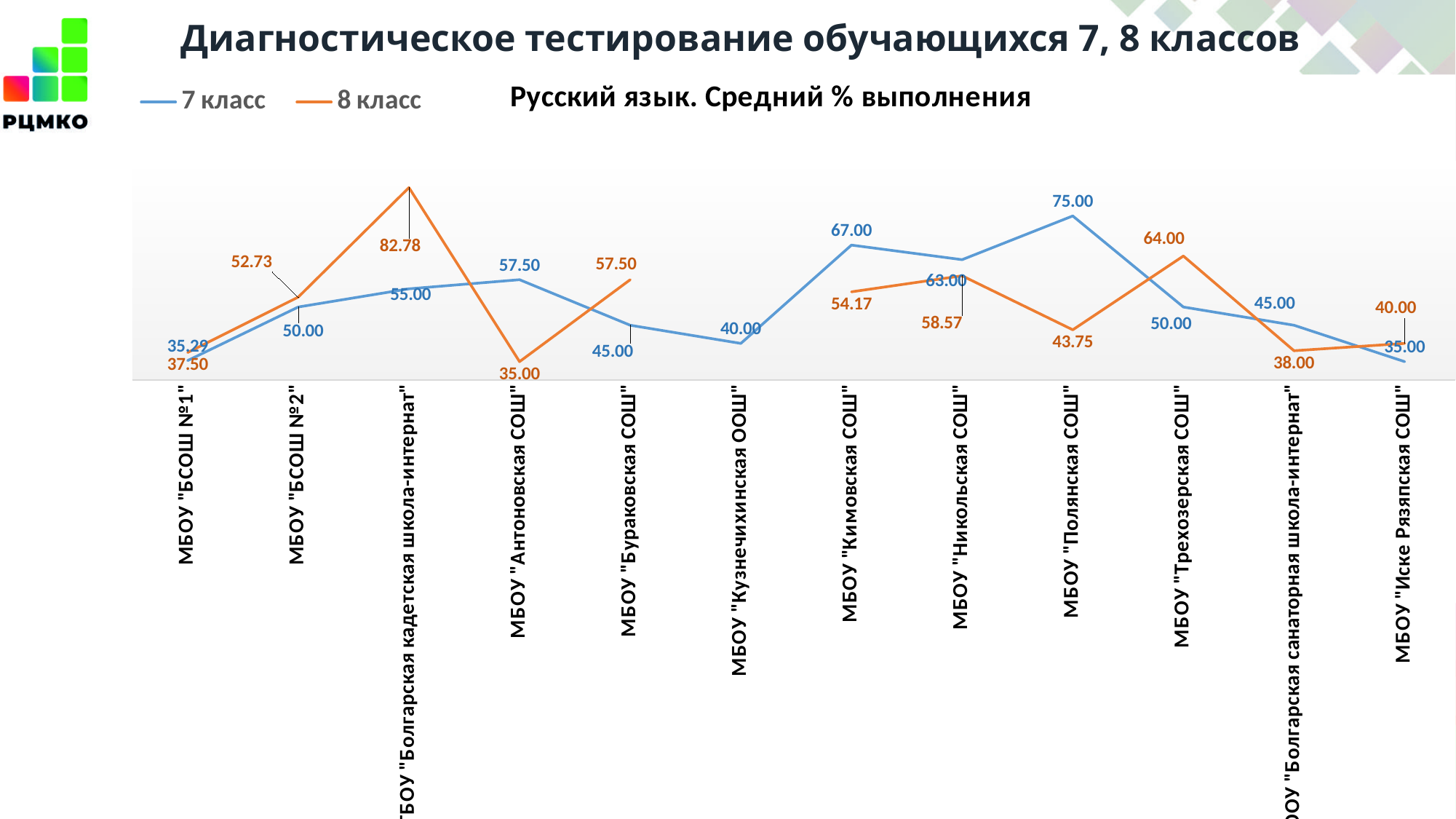
How many schools are shown on the x axis? 12 What is the title of the chart? Русский язык. Средний % выполнения What is the 8 класс value for МБОУ "Антоновская СОШ"? 35.00 How many series does the legend list? 2 What is the 7 класс value for МБОУ "Полянская СОШ"? 75.00 Which series has the larger value for МБОУ "Кимовская СОШ", 7 класс or 8 класс? 7 класс Which school has the highest 8 класс value? ГБОУ "Болгарская кадетская школа-интернат" Which school has the lowest 8 класс value? МБОУ "Антоновская СОШ" What kind of chart is shown? Line chart Which school has the highest 7 класс value? МБОУ "Полянская СОШ" What is the difference between the 7 класс and 8 класс values for МБОУ "Полянская СОШ"? 31.25